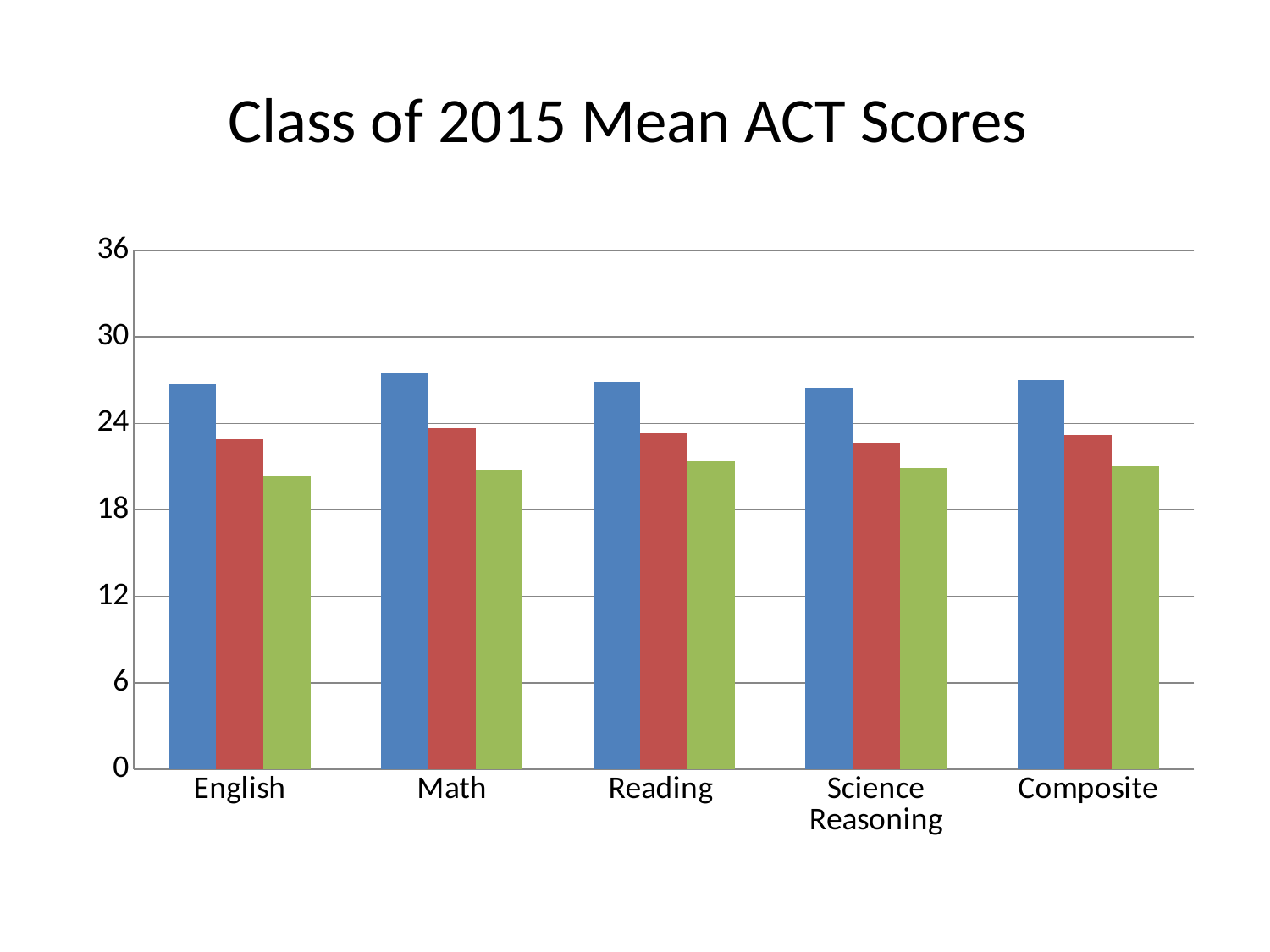
Among the blue bars, which category has the highest value? Math Is the value of the blue bar for English greater or less than 30? less What kind of chart is shown on the slide? bar chart Is the value of the red bar for Science Reasoning greater or less than 24? less Is the value of the blue bar for Math greater or less than 24? greater How many bars are plotted for each category? 3 How many categories are shown on the x axis? 5 In the English group, which is taller, the blue bar or the green bar? blue In the Composite group, which is taller, the red bar or the green bar? red What is the title of the chart? Class of 2015 Mean ACT Scores